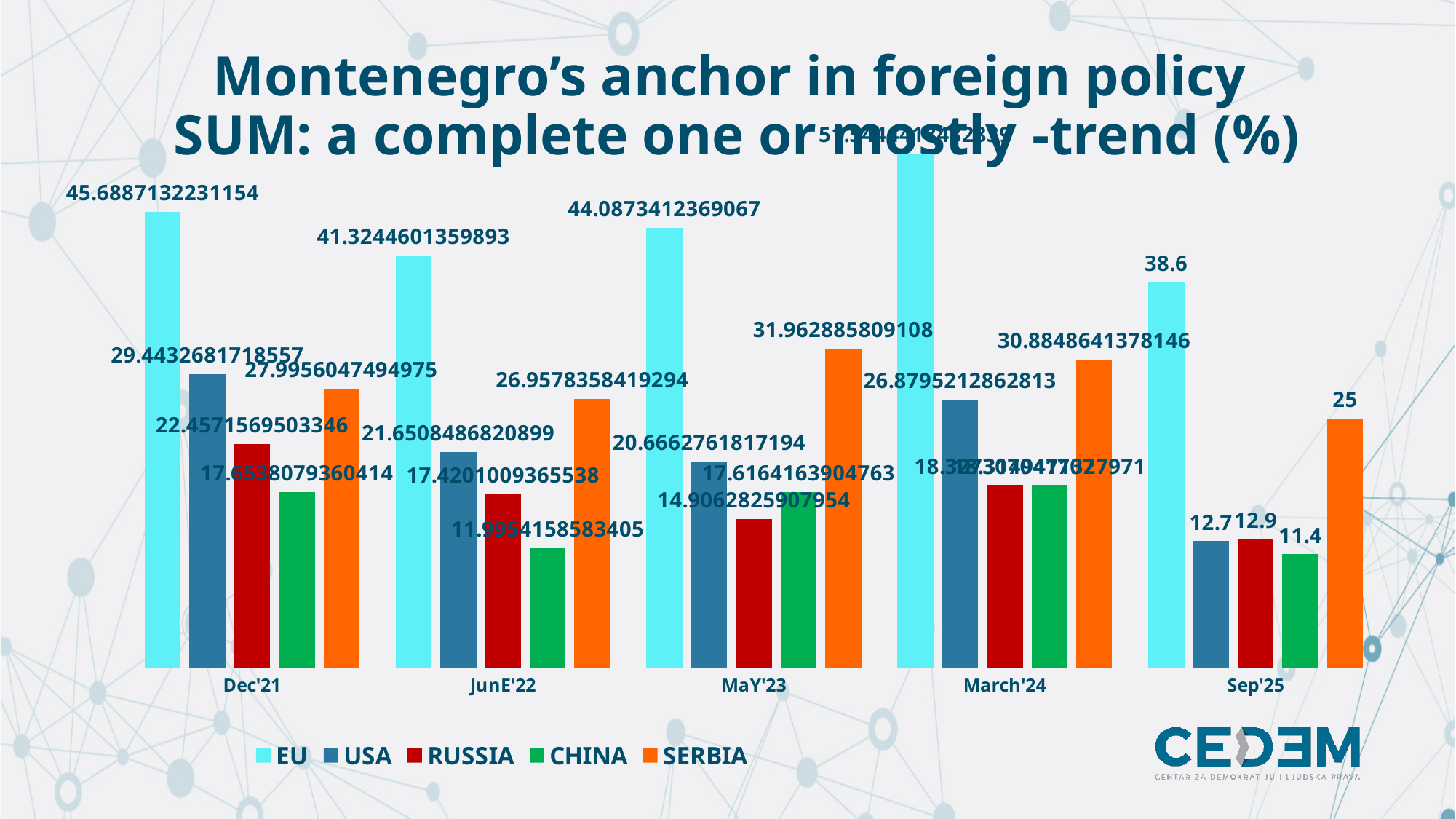
What kind of chart is shown on the slide? bar chart What is the SERBIA value for Sep'25? 25 What is the EU value for Sep'25? 38.6 How many time periods are shown on the x axis? 5 Which series has the highest value in Sep'25? EU Which series has the lowest value in Sep'25? CHINA What is the difference between the EU and SERBIA values in Sep'25? 13.6 Which is larger in MaY'23, the SERBIA value or the USA value? SERBIA What is the EU value for Dec'21? 45.6887132231154 How many series does the legend list? 5 What is the SERBIA value for MaY'23? 31.962885809108 What is the USA value for March'24? 26.8795212862813